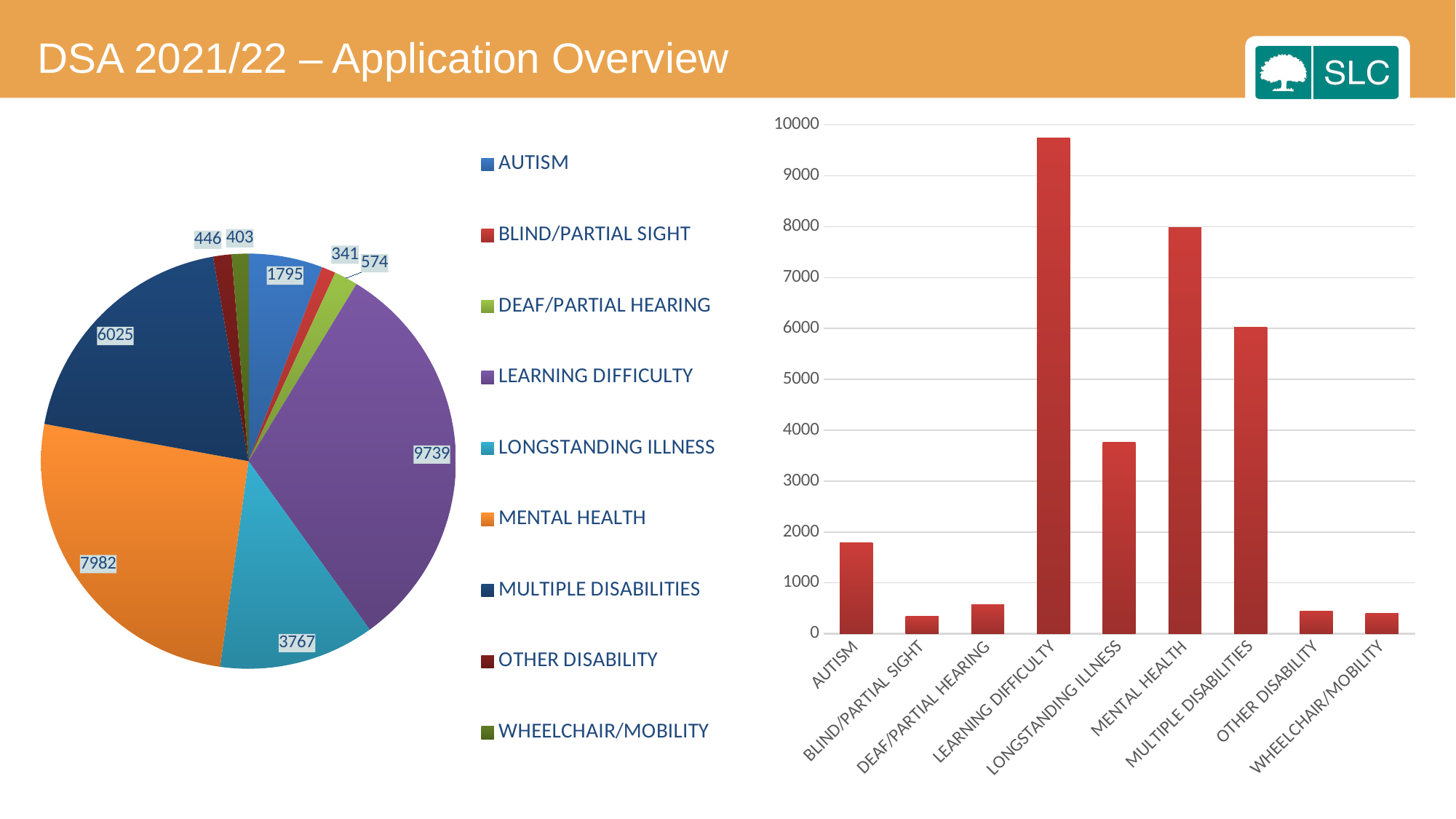
On the bar chart, is the value for AUTISM greater or less than 2000? less What kind of chart is on the right side of the slide? Bar chart On the pie chart, what is the value for MENTAL HEALTH? 7982 On the pie chart, what is the difference between the values for MENTAL HEALTH and MULTIPLE DISABILITIES? 1957 On the pie chart, which category has the largest slice? LEARNING DIFFICULTY On the pie chart, which category has the smallest slice? BLIND/PARTIAL SIGHT How many categories does the pie chart's legend list? 9 On the pie chart, which is larger: the value for AUTISM or the value for DEAF/PARTIAL HEARING? AUTISM On the pie chart, which colour represents MENTAL HEALTH? Orange On the pie chart, what is the value for BLIND/PARTIAL SIGHT? 341 On the bar chart, is the value for LEARNING DIFFICULTY greater or less than 9000? greater On the pie chart, what is the value for LEARNING DIFFICULTY? 9739